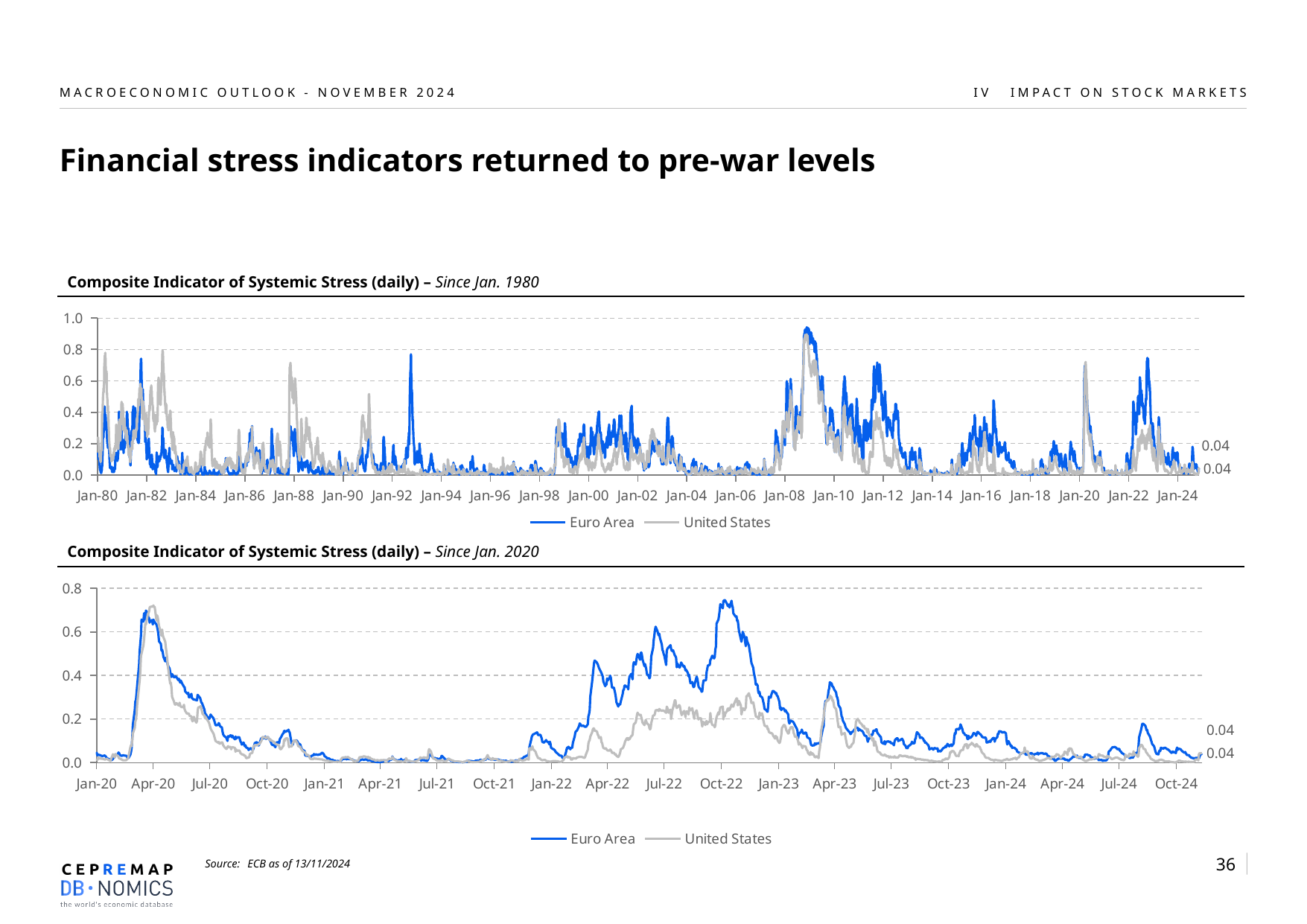
In the bottom chart (Since Jan. 2020), is the Euro Area peak around Oct-22 greater or less than 0.6? greater In the bottom chart (Since Jan. 2020), does the Euro Area series rise or fall from Oct-22 to Oct-24? Falls In the top chart (Since Jan. 1980), what is the latest labelled value for the Euro Area? 0.04 What kind of chart is the top chart, 'Composite Indicator of Systemic Stress (daily) – Since Jan. 1980'? Line chart In the bottom chart (Since Jan. 2020), is the United States peak around Apr-20 greater or less than 0.6? greater In the bottom chart (Since Jan. 2020), what is the difference between the latest labelled Euro Area value and the latest labelled United States value? 0.00 In the bottom chart (Since Jan. 2020), what is the latest labelled value for the United States? 0.04 In the bottom chart (Since Jan. 2020), around Oct-22, which series is higher: Euro Area or United States? Euro Area How many series does the legend of the bottom chart, 'Since Jan. 2020', list? 2 Which two series are listed in the legend of the top chart (Since Jan. 1980)? Euro Area and United States In the top chart (Since Jan. 1980), is the Euro Area peak around 2008–2009 greater or less than 0.8? greater In the top chart (Since Jan. 1980), which series reaches the highest peak over the whole period? Euro Area